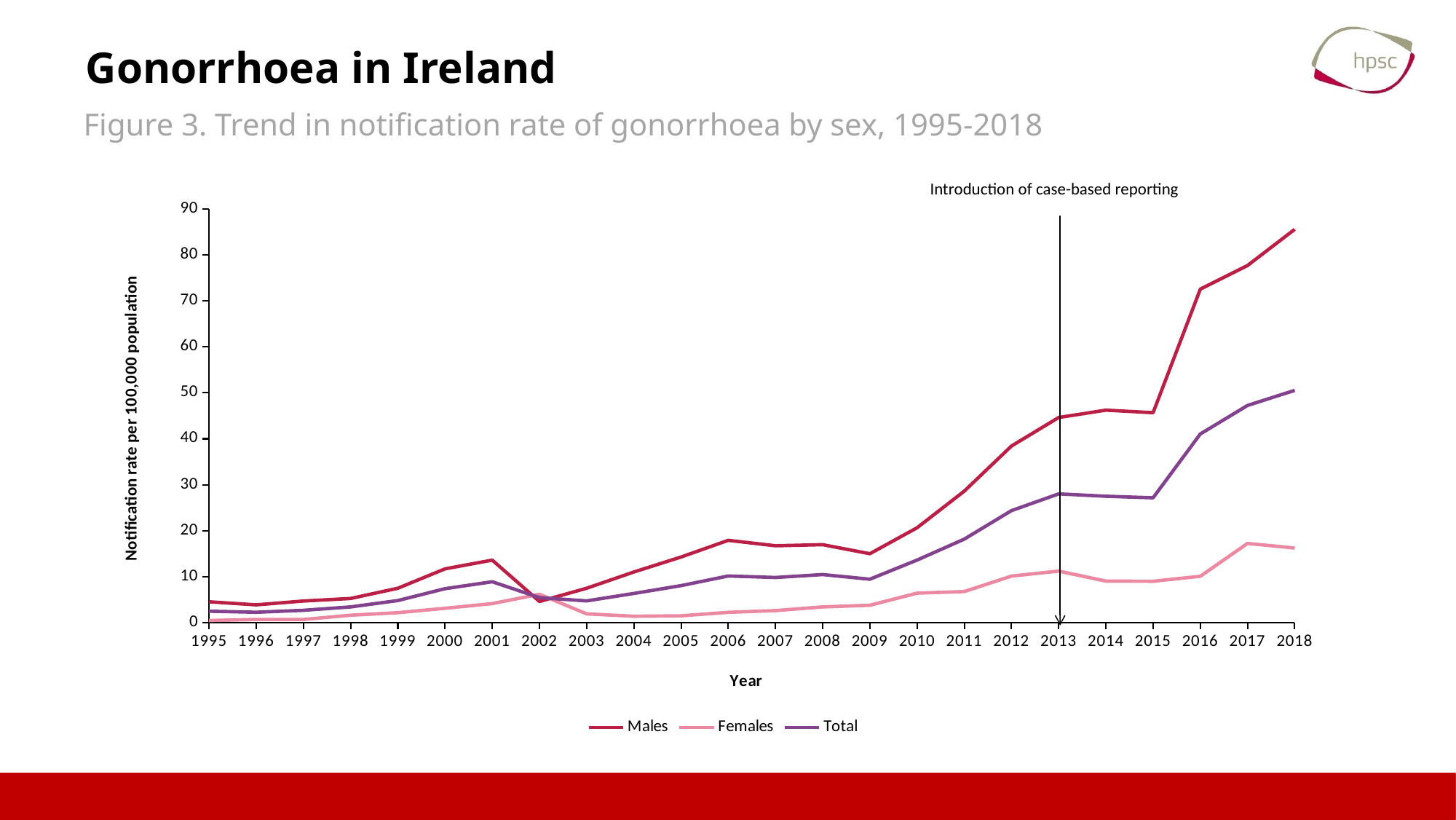
How many years are plotted along the x axis? 24 What event does the vertical line at 2013 mark, according to the annotation? Introduction of case-based reporting In which year does the Males series reach its highest value? 2018 Which is larger in 2018, the value for Males or the value for Females? Males What kind of chart is shown on the slide? Line chart Do the values for Males rise or fall from 2013 to 2018? Rise Is the value for Males in 2018 greater or less than 80? greater Is the value for Females in 2004 greater or less than 10? less Is the value for Males in 2016 greater or less than 70? greater How many series does the legend list? 3 What is the title of the y axis? Notification rate per 100,000 population